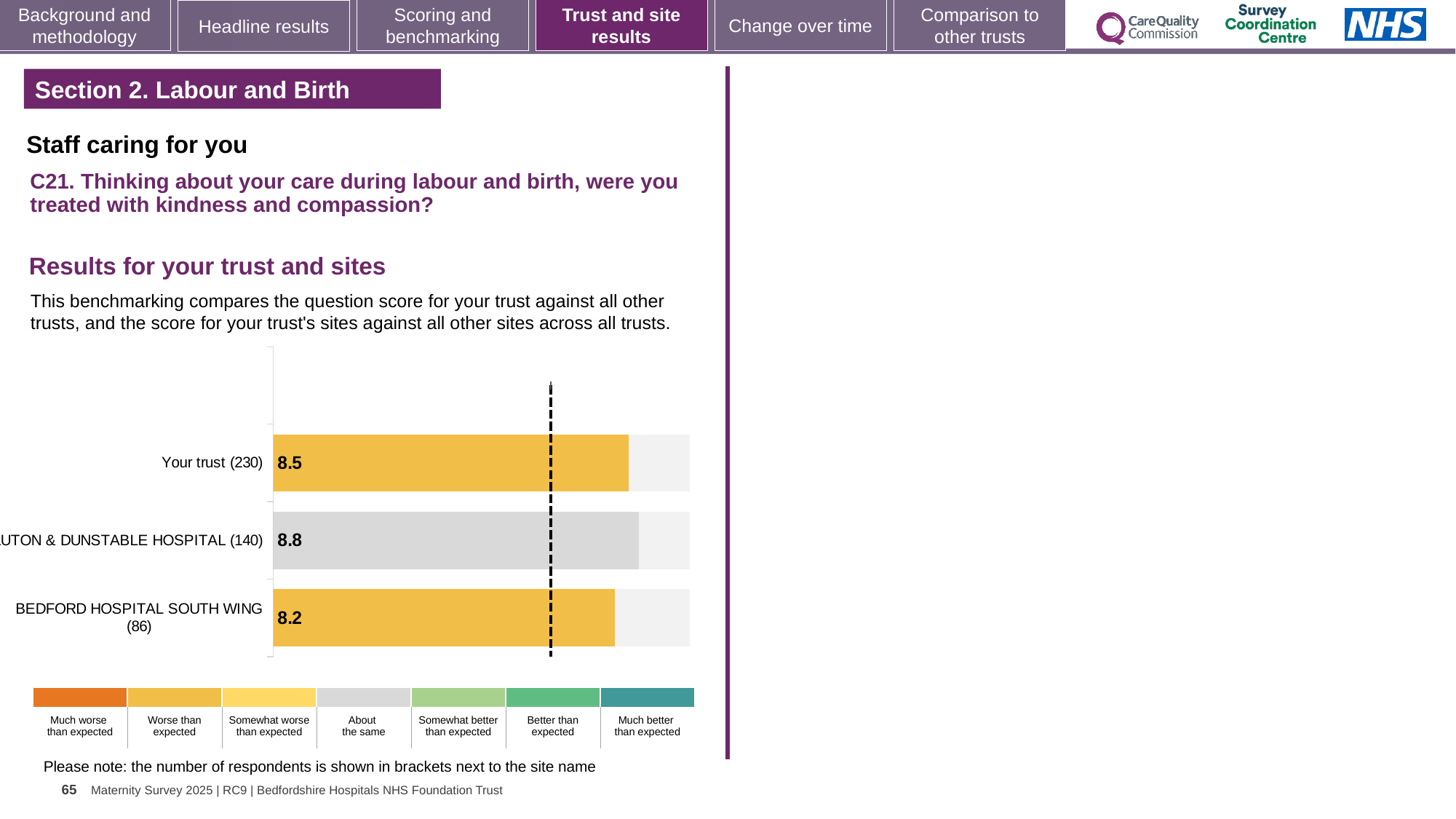
What is the score for Luton & Dunstable Hospital (140)? 8.8 What is the difference between the scores for Luton & Dunstable Hospital and Bedford Hospital South Wing? 0.6 Which bar has the highest score? Luton & Dunstable Hospital (140) How many bars are shown in the chart? 3 Which bar has the lowest score? Bedford Hospital South Wing (86) What is the difference between the scores for Your trust and Bedford Hospital South Wing? 0.3 Which has the higher score, Your trust or Luton & Dunstable Hospital? Luton & Dunstable Hospital According to the colour key, which benchmark category does the grey bar for Luton & Dunstable Hospital represent? About the same What is the score for Your trust (230)? 8.5 What type of chart is shown on the slide? Bar chart What is the score for Bedford Hospital South Wing (86)? 8.2 How many respondents are shown in brackets for Your trust? 230